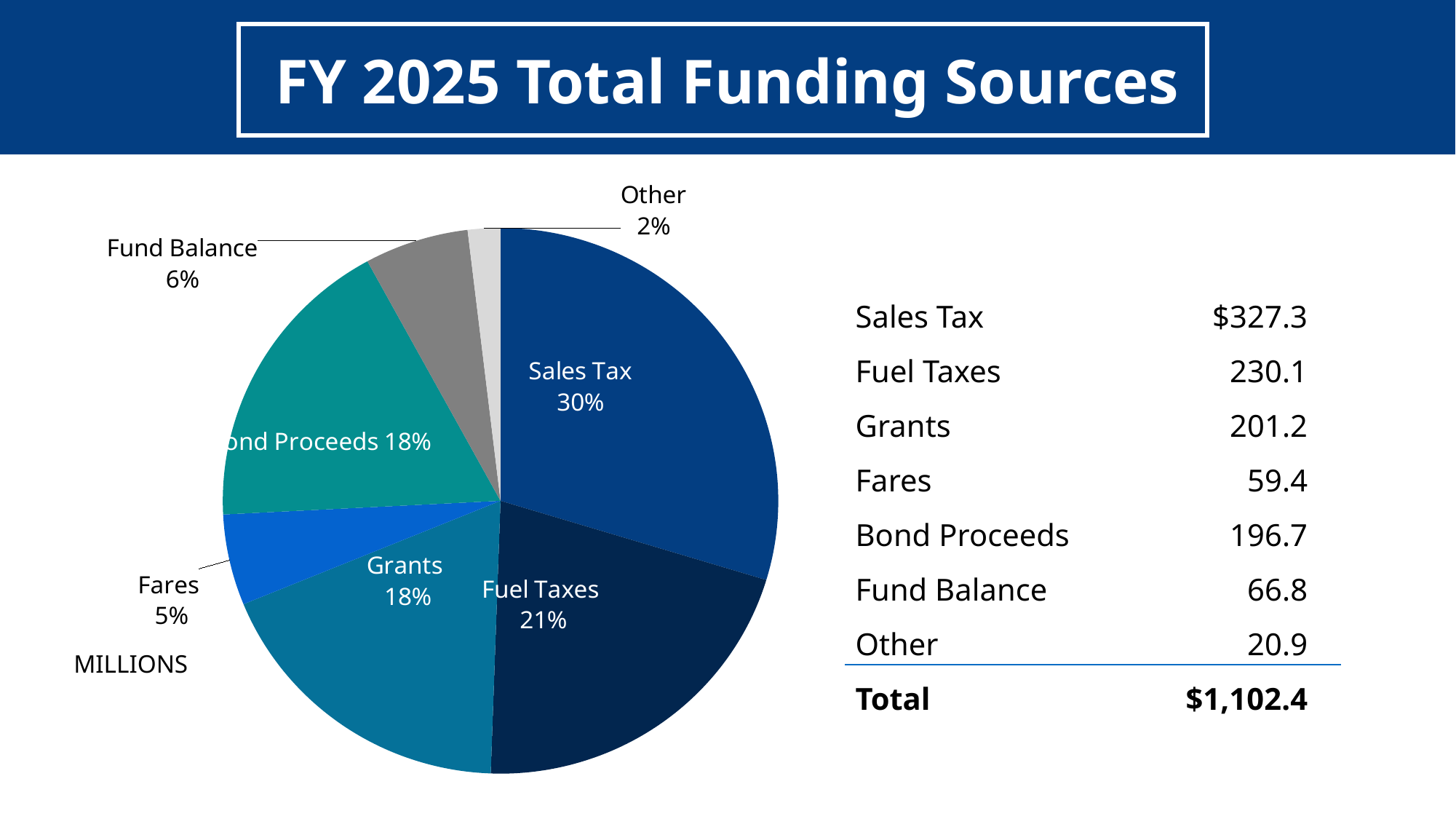
What colour is the Fund Balance slice of the pie? gray Which is larger, the Fuel Taxes slice or the Fares slice? Fuel Taxes What is the difference in percentage points between the Sales Tax slice and the Fuel Taxes slice? 9 How many slices does the pie chart have? 7 Which slice of the pie is the smallest? Other What share of the pie does Other represent? 2% Which slice of the pie is the largest? Sales Tax What is the title of the slide containing the pie chart? FY 2025 Total Funding Sources What share of the pie does Fuel Taxes represent? 21% What share of the pie does Fund Balance represent? 6% What kind of chart is shown on the slide? pie chart